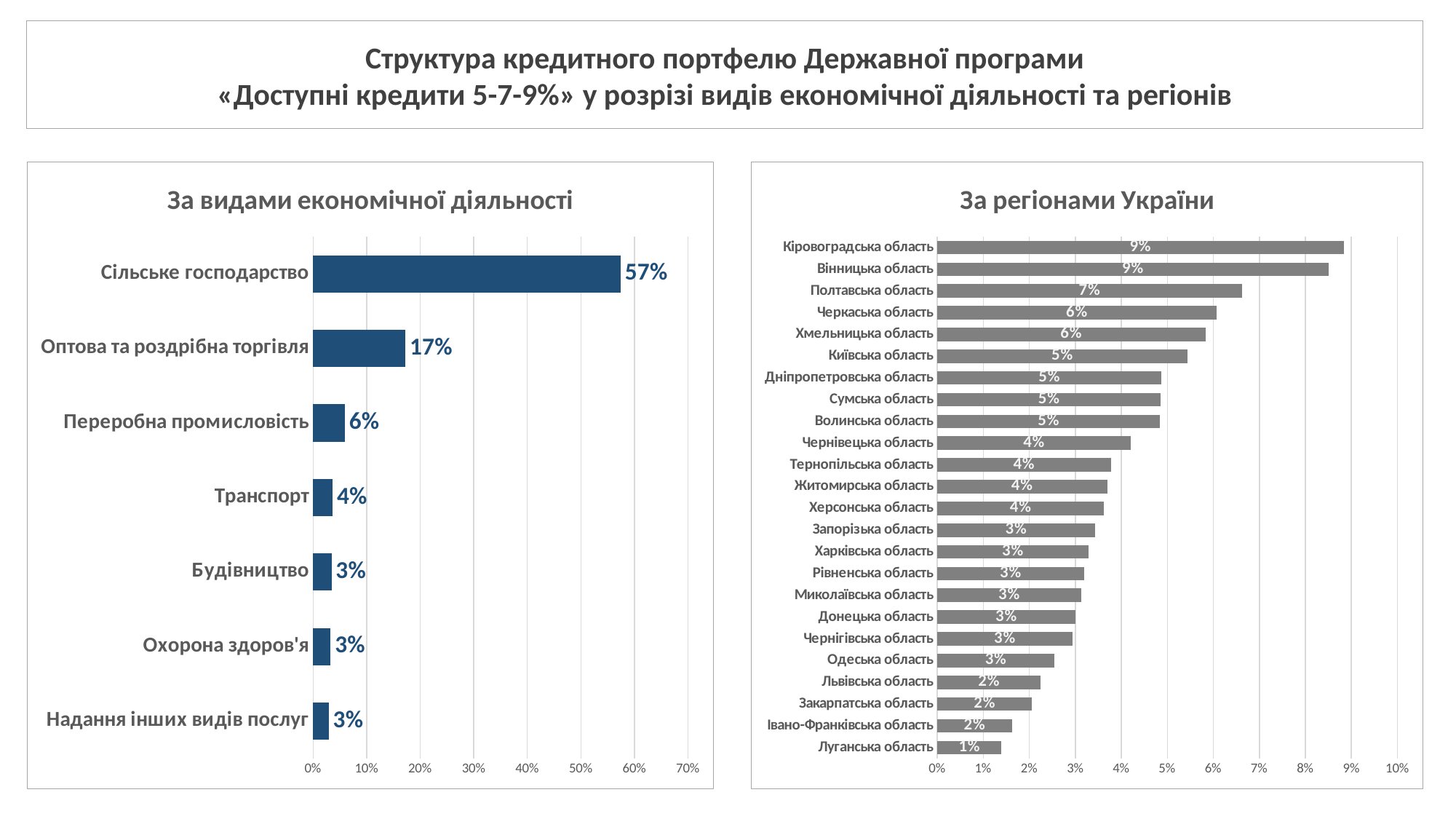
In the chart 'За видами економічної діяльності', which is larger: Переробна промисловість or Транспорт? Переробна промисловість In the chart 'За видами економічної діяльності', what is the value for Оптова та роздрібна торгівля? 17% In the chart 'За видами економічної діяльності', how many categories are shown? 7 In the chart 'За регіонами України', is the value for Кіровоградська область greater or less than 8%? greater In the chart 'За регіонами України', how many regions are shown? 24 In the chart 'За видами економічної діяльності', what is the difference between Сільське господарство and Оптова та роздрібна торгівля? 40% In the chart 'За видами економічної діяльності', what is the value for Сільське господарство? 57% What type of chart is 'За регіонами України'? Bar chart In the chart 'За регіонами України', what is the value for Луганська область? 1% In the chart 'За регіонами України', which region has the lowest value? Луганська область In the chart 'За видами економічної діяльності', which category has the highest value? Сільське господарство In the chart 'За регіонами України', what is the value for Полтавська область? 7%